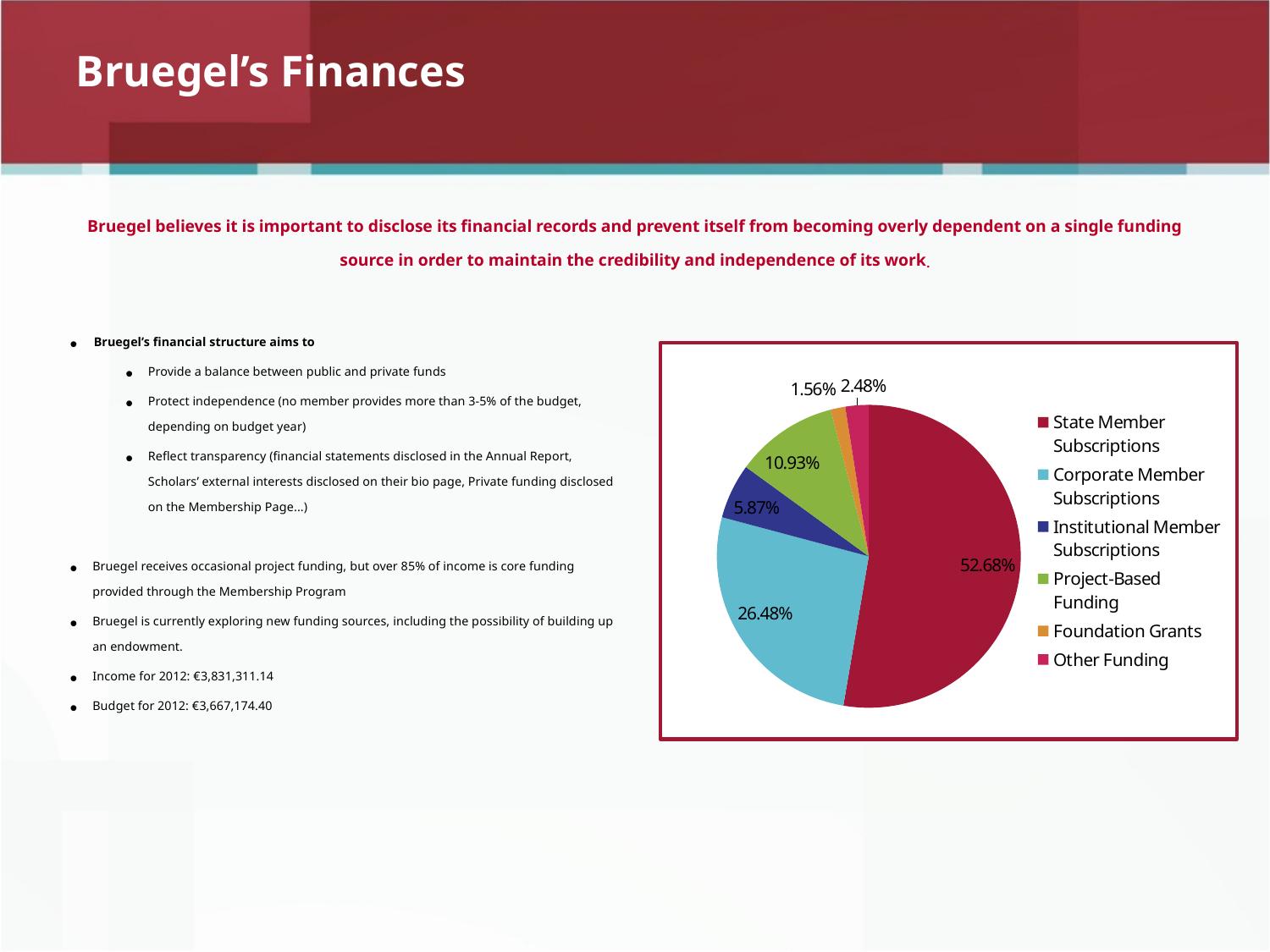
What share of the pie is Other Funding? 2.48% Which category has the smallest share of the pie? Foundation Grants What kind of chart is shown on the slide? pie chart What share of the pie is Institutional Member Subscriptions? 5.87% What is the difference between the shares of State Member Subscriptions and Corporate Member Subscriptions? 26.20% Which category has the largest share of the pie? State Member Subscriptions What colour is the slice for Corporate Member Subscriptions? light blue Which is larger, the share for Project-Based Funding or the share for Institutional Member Subscriptions? Project-Based Funding How many categories does the legend list? 6 What share of the pie is State Member Subscriptions? 52.68% What share of the pie is Corporate Member Subscriptions? 26.48% What share of the pie is Project-Based Funding? 10.93%